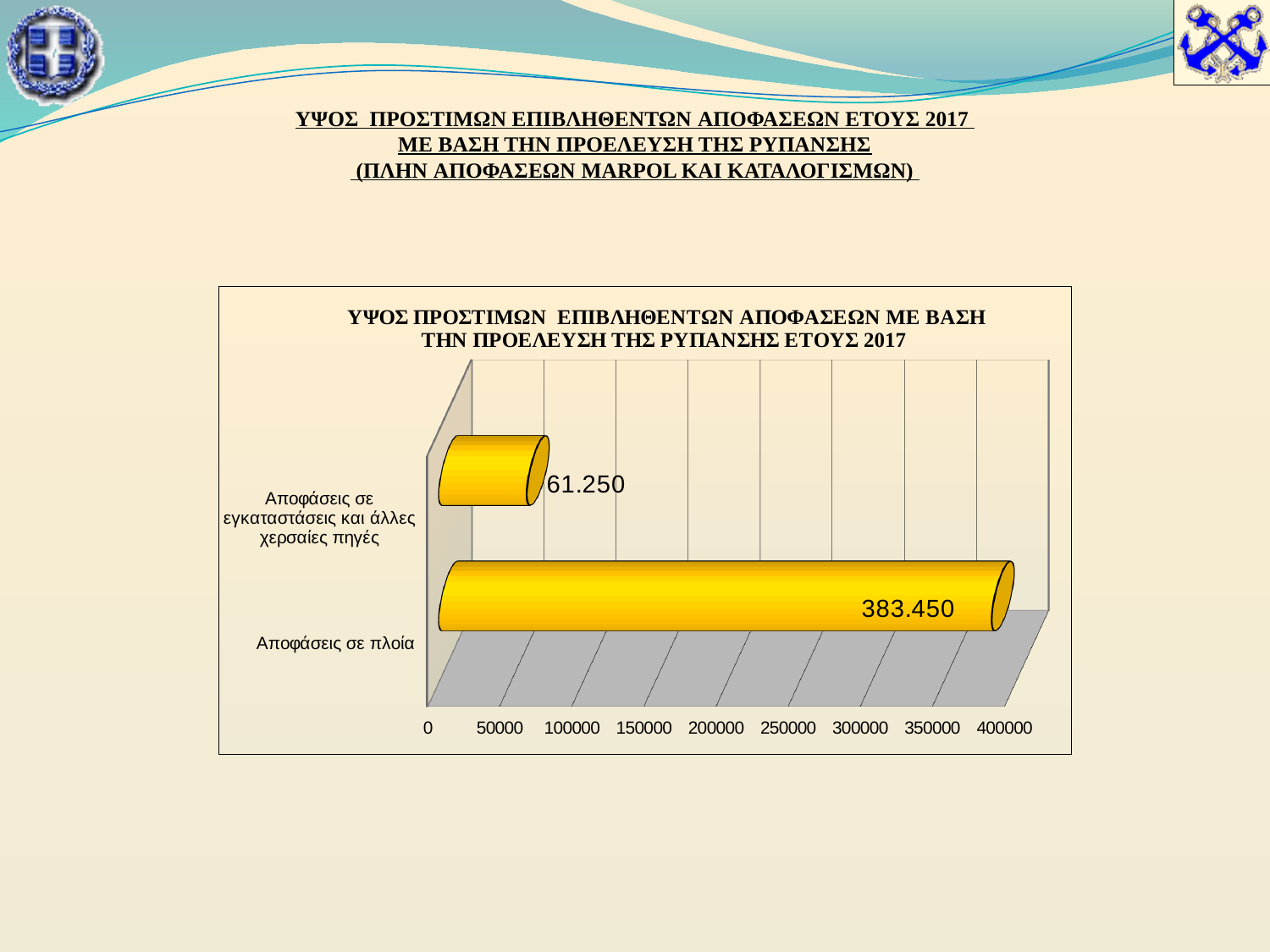
Which category has the highest value? Αποφάσεις σε πλοία How many categories are shown in the chart? 2 Is the value for Αποφάσεις σε εγκαταστάσεις και άλλες χερσαίες πηγές greater or less than 100000? less Which is larger: the value for Αποφάσεις σε πλοία or the value for Αποφάσεις σε εγκαταστάσεις και άλλες χερσαίες πηγές? Αποφάσεις σε πλοία Is the value for Αποφάσεις σε πλοία greater or less than 350000? greater What is the value for Αποφάσεις σε εγκαταστάσεις και άλλες χερσαίες πηγές? 61.250 What is the value for Αποφάσεις σε πλοία? 383.450 What kind of chart is shown on the slide? Bar chart Which category has the lowest value? Αποφάσεις σε εγκαταστάσεις και άλλες χερσαίες πηγές What is the difference between the value for Αποφάσεις σε πλοία and the value for Αποφάσεις σε εγκαταστάσεις και άλλες χερσαίες πηγές? 322.200 What is the highest value shown on the horizontal axis of the chart? 400000 What is the total of the two values shown in the chart? 444.700